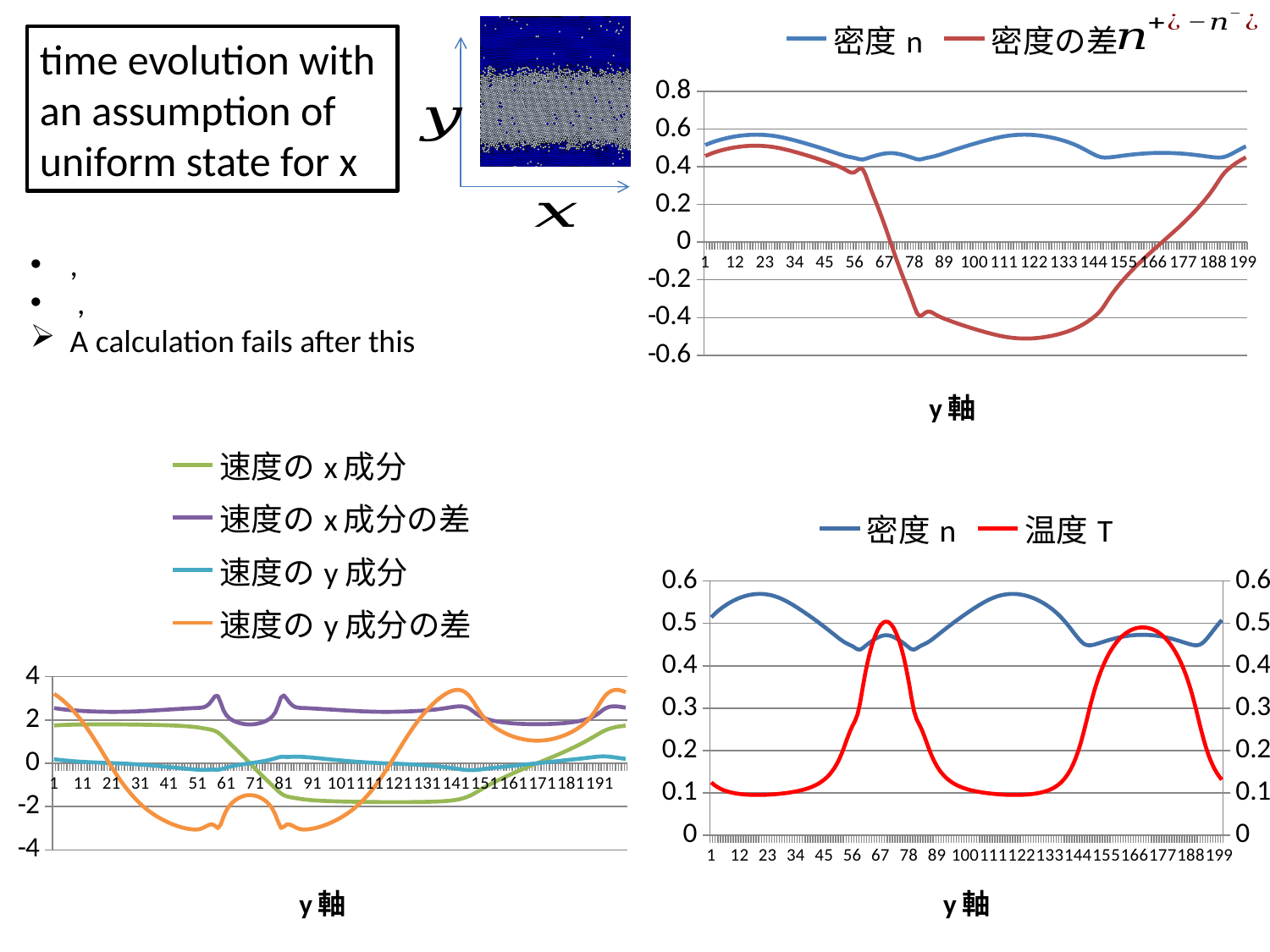
In the top-right chart, does the 密度の差 line rise or fall between x = 56 and x = 78? fall What is the x-axis title of the bottom-right chart? y軸 How many series does the legend of the bottom-right chart list? 2 In the bottom-right chart, is the value of 温度 T at x = 67 greater or less than 0.4? greater How many series does the legend of the top-right chart list? 2 What kind of chart is the top-right chart titled with the legend 密度 n and 密度の差? line chart In the bottom-left chart, is the value of 速度のx成分の差 at x = 11 greater or less than 2? greater How many series does the legend of the bottom-left chart list? 4 In the bottom-left chart, is the value of 速度のx成分 at x = 101 greater or less than 0? less